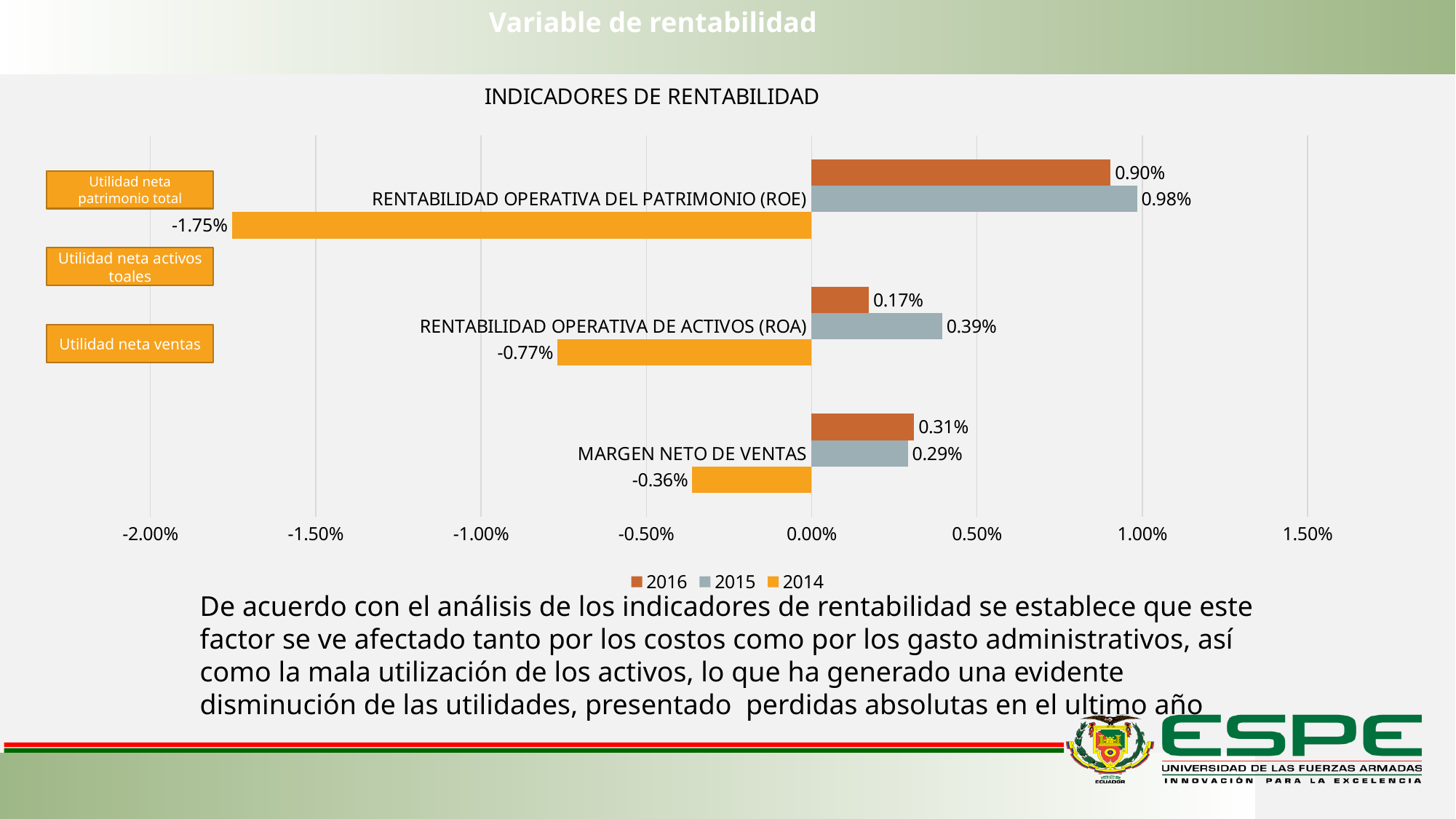
What is the difference between the 2015 and 2016 values for RENTABILIDAD OPERATIVA DE ACTIVOS (ROA)? 0.22% What is the value for 2014 for RENTABILIDAD OPERATIVA DE ACTIVOS (ROA)? -0.77% What is the title of the chart? INDICADORES DE RENTABILIDAD Which category has the lowest value for the 2014 series? RENTABILIDAD OPERATIVA DEL PATRIMONIO (ROE) What is the value for 2016 for MARGEN NETO DE VENTAS? 0.31% What kind of chart is shown on the slide? Bar chart What is the value for 2015 for RENTABILIDAD OPERATIVA DEL PATRIMONIO (ROE)? 0.98% What is the value for 2014 for RENTABILIDAD OPERATIVA DEL PATRIMONIO (ROE)? -1.75% How many series does the legend list? 3 Which category has the highest value for the 2015 series? RENTABILIDAD OPERATIVA DEL PATRIMONIO (ROE) For MARGEN NETO DE VENTAS, which is larger: the 2016 value or the 2015 value? 2016 How many categories are shown on the chart? 3